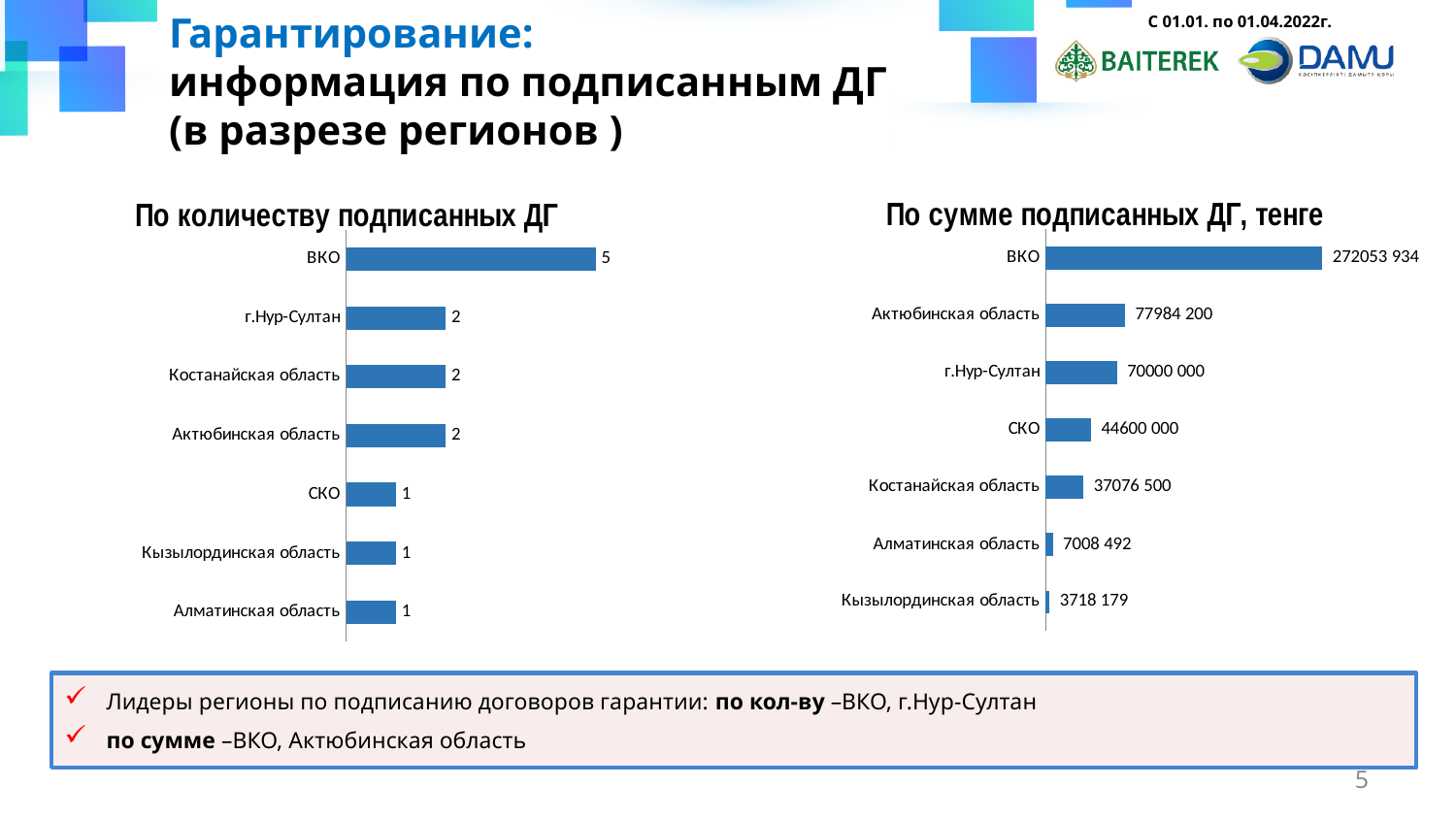
In the chart 'По количеству подписанных ДГ', what is the value for ВКО? 5 In the chart 'По сумме подписанных ДГ, тенге', what is the value for Актюбинская область? 77984 200 In the chart 'По количеству подписанных ДГ', how many regions are shown? 7 In the chart 'По сумме подписанных ДГ, тенге', how many regions are shown? 7 In the chart 'По сумме подписанных ДГ, тенге', which region has the lowest value? Кызылординская область In the chart 'По количеству подписанных ДГ', what is the value for СКО? 1 In the chart 'По количеству подписанных ДГ', which region has the highest value? ВКО In the chart 'По сумме подписанных ДГ, тенге', which is larger: г.Нур-Султан or СКО? г.Нур-Султан In the chart 'По сумме подписанных ДГ, тенге', what is the value for Костанайская область? 37076 500 In the chart 'По сумме подписанных ДГ, тенге', what is the value for Кызылординская область? 3718 179 In the chart 'По количеству подписанных ДГ', what is the difference between ВКО and г.Нур-Султан? 3 What type of chart is 'По сумме подписанных ДГ, тенге'? Bar chart